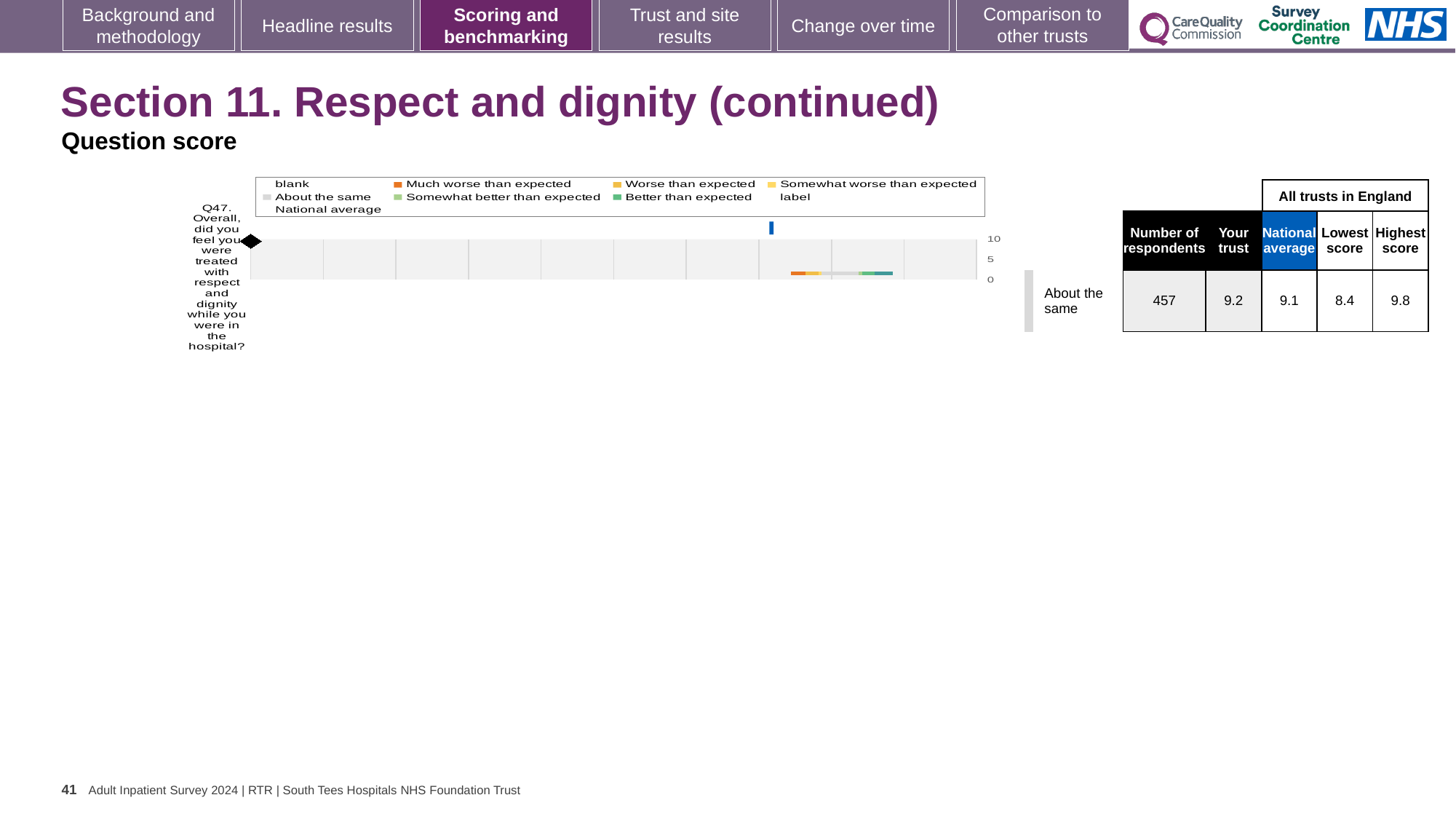
What is the highest score among all trusts in England for Q47? 9.8 What kind of chart is shown for Q47 on this slide? bar chart How many survey questions are plotted on the chart? 1 What colour does the legend use for 'Much worse than expected'? orange Is the 'Your trust' score for Q47 greater or less than 5 on the chart's axis? greater What is the difference between the highest and lowest scores for Q47 across all trusts in England? 1.4 What is the lowest score among all trusts in England for Q47? 8.4 What is the 'Your trust' score for Q47? 9.2 What is the highest value shown on the chart's score axis? 10 How many respondents answered Q47? 457 Which is larger for Q47, the 'Your trust' score or the national average? Your trust What is the national average score for Q47? 9.1